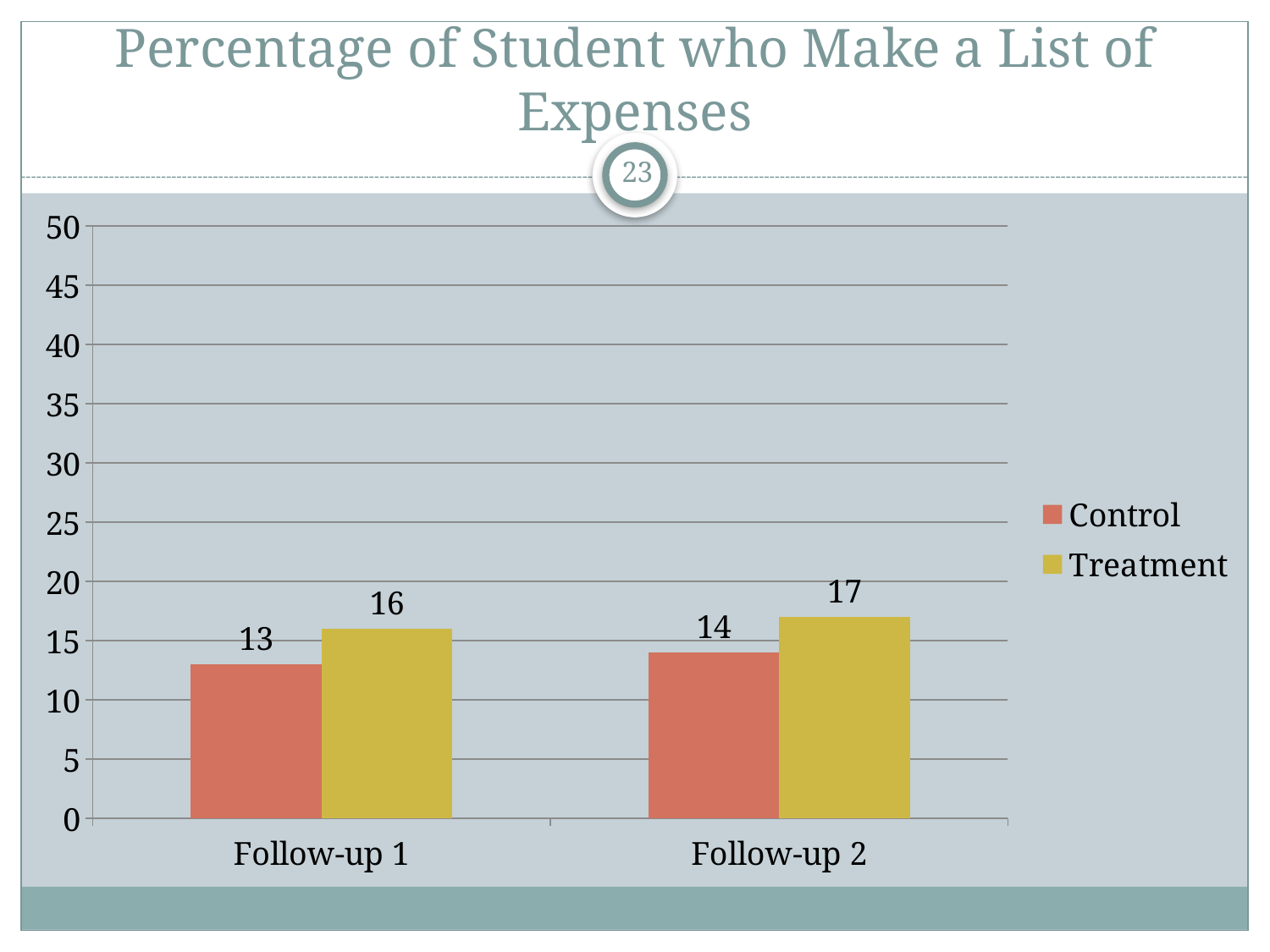
How many categories are shown on the x axis? 2 Which bar has the lowest value on the chart? Control, Follow-up 1 What is the Treatment value for Follow-up 1? 16 Which is larger at Follow-up 2, Control or Treatment? Treatment What is the difference between the Treatment and Control values at Follow-up 1? 3 What is the Control value for Follow-up 1? 13 What is the Treatment value for Follow-up 2? 17 Does the Control value rise or fall from Follow-up 1 to Follow-up 2? Rise How many series does the legend list? 2 Which bar has the highest value on the chart? Treatment, Follow-up 2 What kind of chart is shown on the slide? Bar chart What is the Control value for Follow-up 2? 14